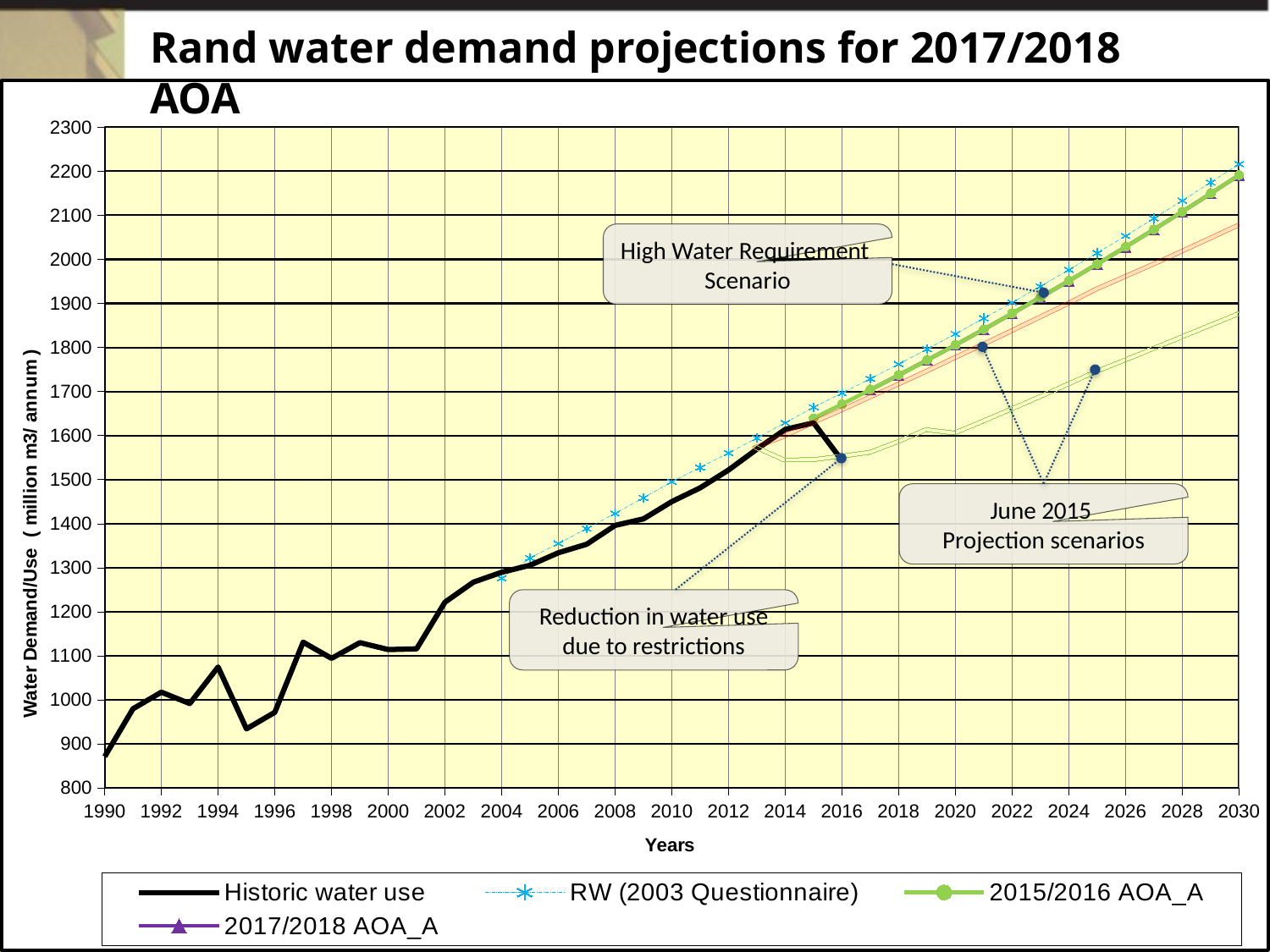
Is the Historic water use value for 2014 greater or less than 1600? greater Is the Historic water use value for 1990 greater or less than 900? less What is the label of the vertical axis? Water Demand/Use ( million m3/ annum) What is the title of the chart? Rand water demand projections for 2017/2018 AOA Is the 2015/2016 AOA_A value for 2026 greater or less than 2000? greater What kind of chart is shown on the slide? Line chart In 2016, which is larger: the RW (2003 Questionnaire) value or the Historic water use value? RW (2003 Questionnaire) In which year does the Historic water use series reach its highest value? 2015 How many series does the legend list? 4 In which year does the Historic water use series have its lowest value? 1990